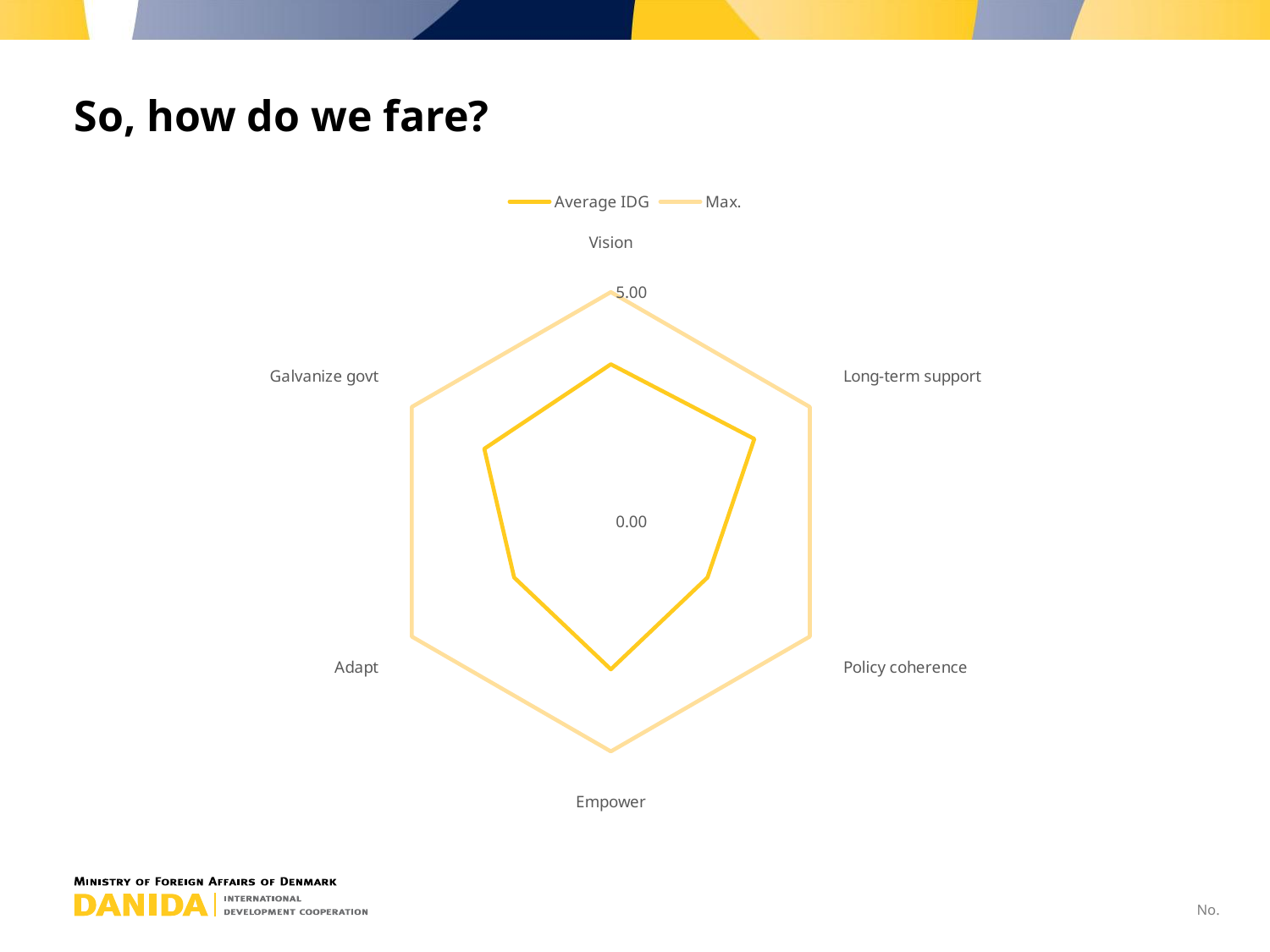
Which is larger for the Average IDG series: Long-term support or Policy coherence? Long-term support Is the Average IDG value for Policy coherence greater or less than 5.00? less How many series does the chart legend list? 2 Which is larger for the Average IDG series: Vision or Adapt? Vision What kind of chart is shown on the slide? Radar chart Which series is drawn as the outer hexagon on the chart? Max. What is the value of the Max. series for Vision? 5.00 What is the value of the Max. series for Empower? 5.00 What are the two series named in the chart legend? Average IDG and Max. Is the Average IDG value for Vision greater or less than 5.00? less How many categories (axes) does the radar chart have? 6 What is the highest axis value shown on the radar chart? 5.00